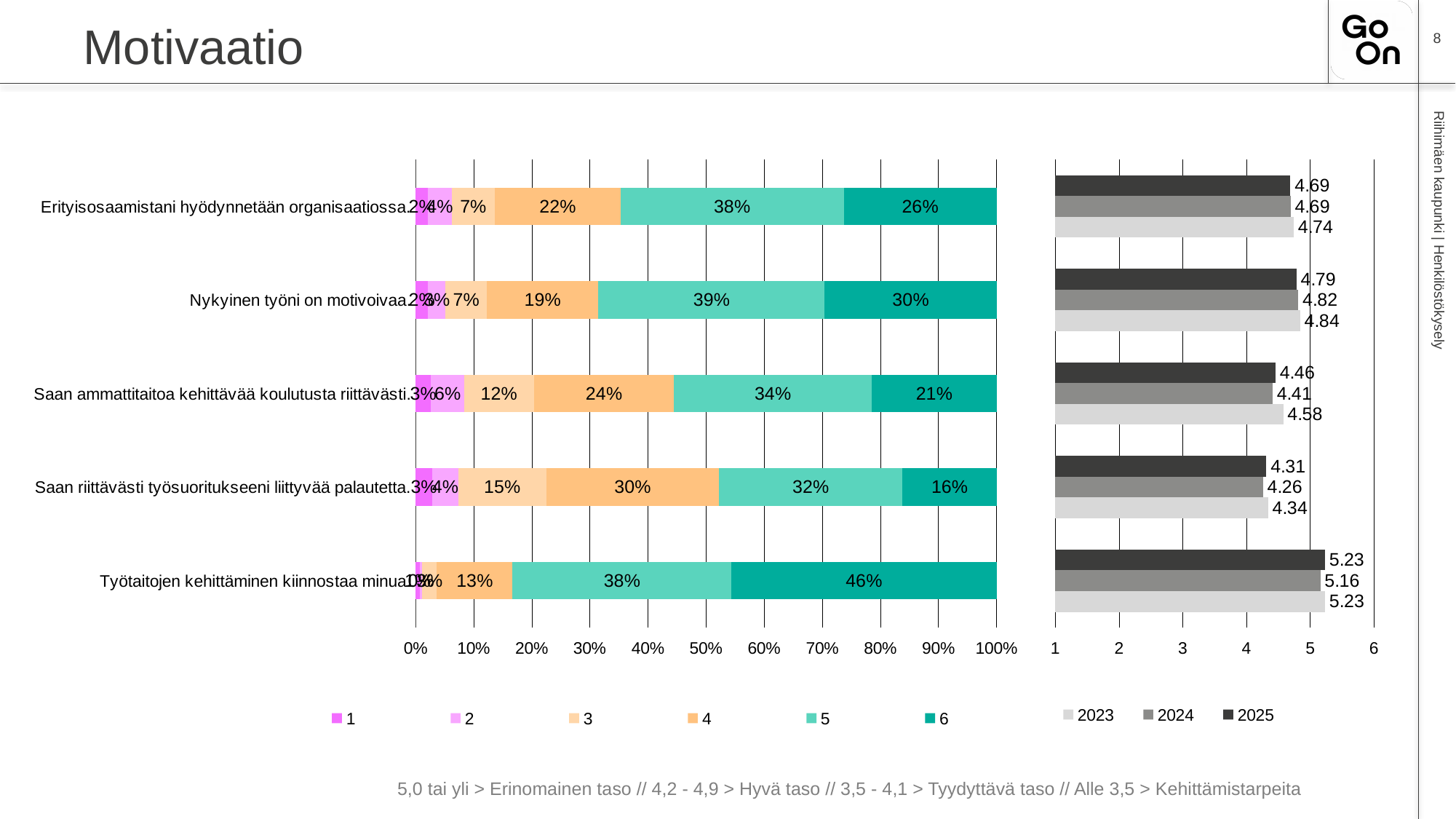
In the right-hand bar chart, what is the 2024 value for "Saan riittävästi työsuoritukseeni liittyvää palautetta"? 4.26 What type of chart is the left-hand chart? Stacked bar chart In the right-hand bar chart, what is the 2025 value for "Työtaitojen kehittäminen kiinnostaa minua"? 5.23 In the right-hand bar chart, which statement has the lowest 2025 value? Saan riittävästi työsuoritukseeni liittyvää palautetta How many series does the legend of the right-hand bar chart list? 3 In the right-hand bar chart, what is the 2023 value for "Saan ammattitaitoa kehittävää koulutusta riittävästi"? 4.58 In the left-hand stacked bar chart, which statement has the larger share of 5 ratings: "Nykyinen työni on motivoivaa" or "Saan riittävästi työsuoritukseeni liittyvää palautetta"? Nykyinen työni on motivoivaa In the left-hand stacked bar chart, what percentage of respondents gave a 4 for "Saan riittävästi työsuoritukseeni liittyvää palautetta"? 30% In the right-hand bar chart, what is the difference between the 2023 and 2024 values for "Saan ammattitaitoa kehittävää koulutusta riittävästi"? 0.17 How many statements are shown in the left-hand stacked bar chart? 5 In the left-hand stacked bar chart, what percentage of respondents gave a 6 for "Nykyinen työni on motivoivaa"? 30% In the right-hand bar chart, which statement has the highest 2024 value? Työtaitojen kehittäminen kiinnostaa minua